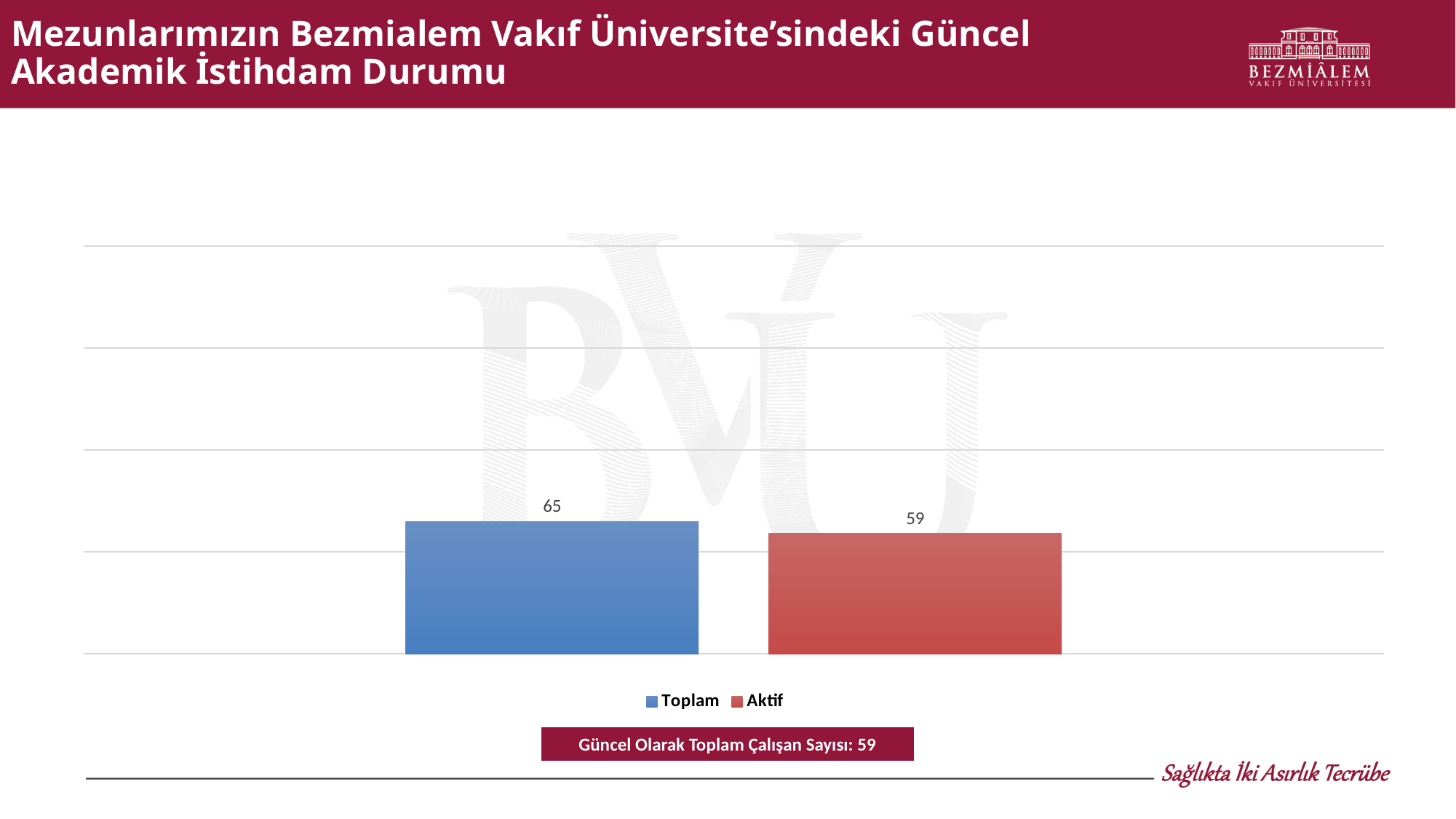
What is the value for Aktif? 59 Which series has the higher value, Toplam or Aktif? Toplam What colour is the Aktif bar? Red Which series has the lowest value? Aktif What is the difference between the Toplam and Aktif values? 6 What is the value for Toplam? 65 How many bars are plotted in the chart? 2 What colour is the Toplam bar? Blue What kind of chart is shown on the slide? Bar chart How many series does the legend list? 2